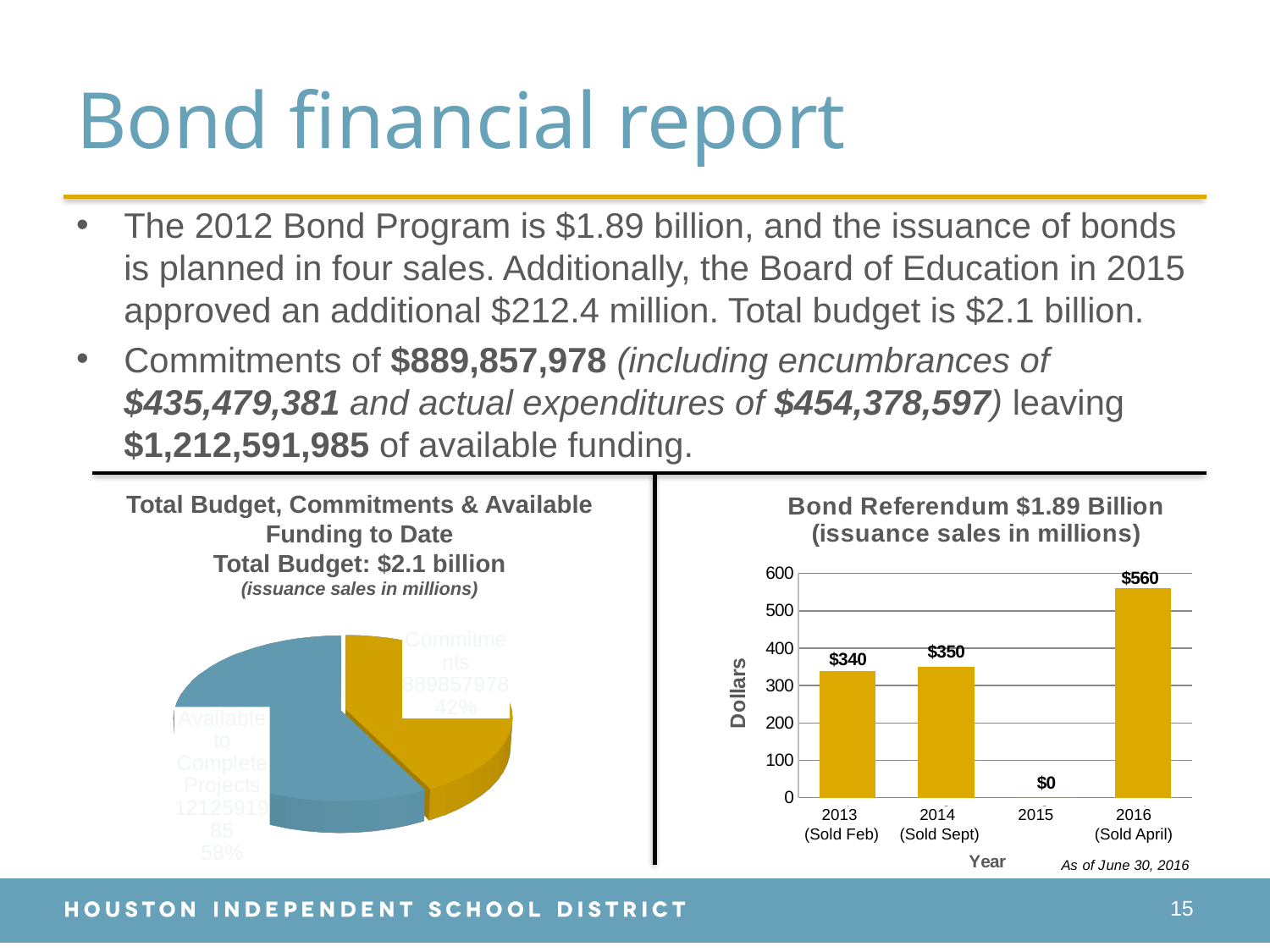
In the Bond Referendum $1.89 Billion chart, which is larger, the value for 2013 or the value for 2014? 2014 In the Bond Referendum $1.89 Billion chart, what is the value for 2016 (Sold April)? $560 In the Bond Referendum $1.89 Billion chart, what is the value for 2015? $0 How many years are shown on the x axis of the Bond Referendum $1.89 Billion chart? 4 In the Bond Referendum $1.89 Billion chart, what is the value for 2013 (Sold Feb)? $340 What kind of chart is the Total Budget, Commitments & Available Funding to Date chart on the left? pie chart In the Bond Referendum $1.89 Billion chart, which year has the highest issuance sales? 2016 (Sold April) What kind of chart is the Bond Referendum $1.89 Billion chart? bar chart In the Bond Referendum $1.89 Billion chart, which year has the lowest issuance sales? 2015 In the Bond Referendum $1.89 Billion chart, what is the difference between the 2016 and 2013 values? $220 What is the y-axis title of the Bond Referendum $1.89 Billion chart? Dollars In the Bond Referendum $1.89 Billion chart, is the value for 2016 greater or less than 500? greater